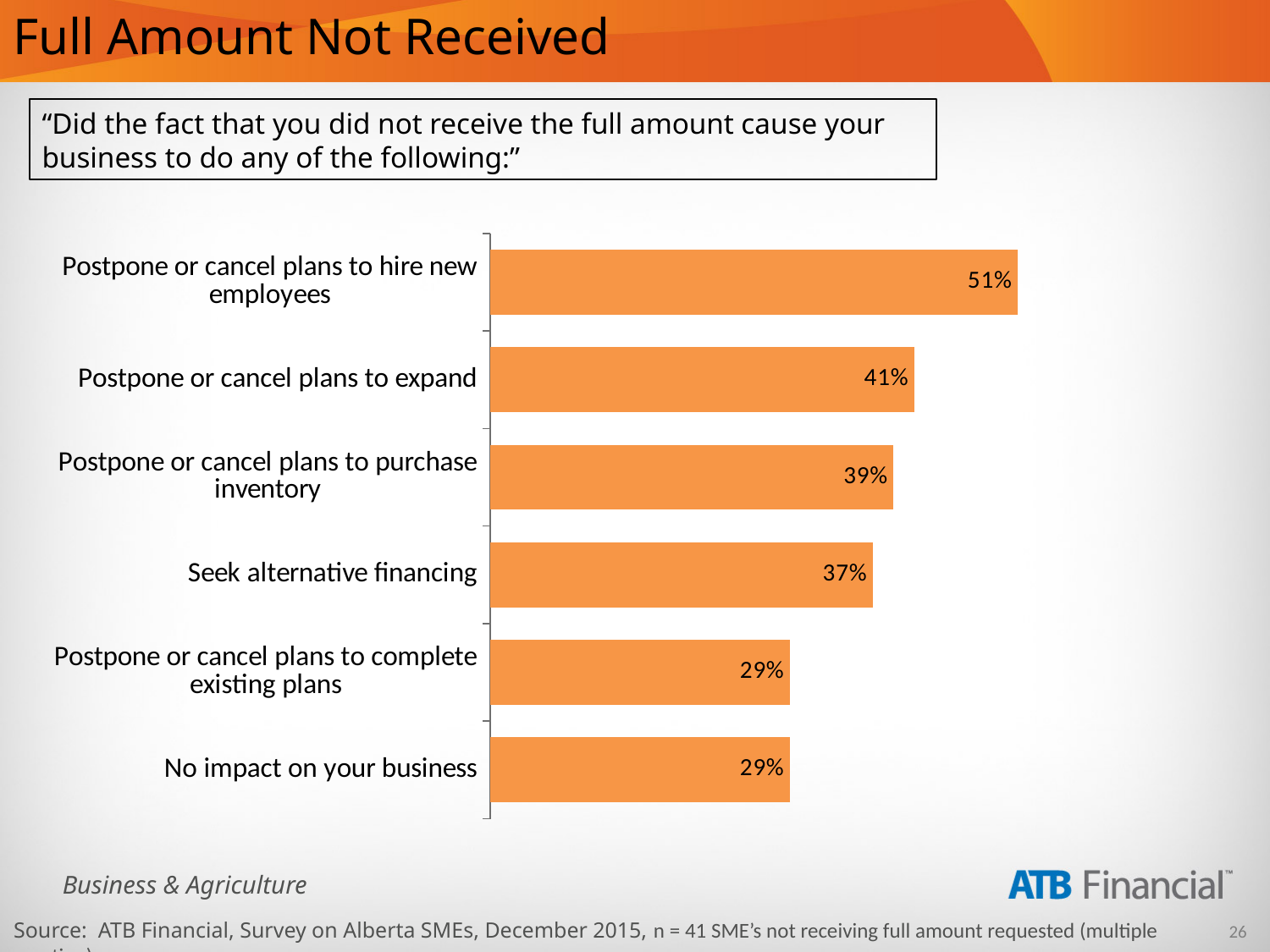
What percentage of respondents said they would postpone or cancel plans to hire new employees? 51% Which category has the highest value? Postpone or cancel plans to hire new employees What is the difference between 'Seek alternative financing' and 'No impact on your business'? 8% What is the title of the slide? Full Amount Not Received What kind of chart is shown on the slide? Bar chart How many categories are shown in the chart? 6 What is the value for 'No impact on your business'? 29% Which two categories share the same value of 29%? Postpone or cancel plans to complete existing plans; No impact on your business What is the value for 'Seek alternative financing'? 37% What is the value for 'Postpone or cancel plans to purchase inventory'? 39% What is the difference between 'Postpone or cancel plans to hire new employees' and 'Postpone or cancel plans to expand'? 10% Which is larger: 'Postpone or cancel plans to expand' or 'Seek alternative financing'? Postpone or cancel plans to expand